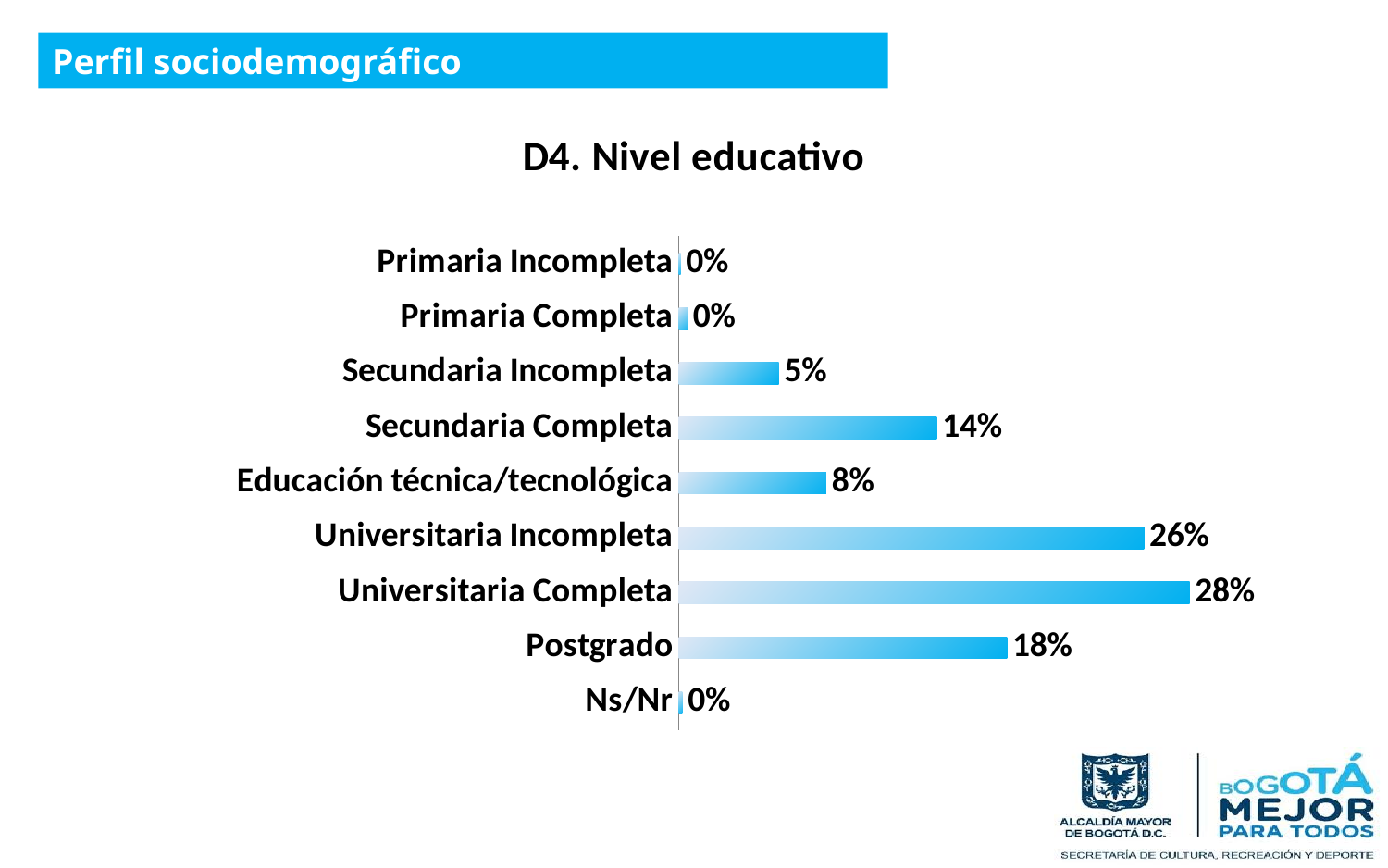
Which category has the highest value? Universitaria Completa Which is larger, Postgrado or Universitaria Incompleta? Universitaria Incompleta What kind of chart is shown on the slide? Bar chart Which is larger, Secundaria Completa or Educación técnica/tecnológica? Secundaria Completa What is the title of the chart? D4. Nivel educativo What is the value for Secundaria Completa? 14% What is the value for Universitaria Completa? 28% What is the difference between Postgrado and Secundaria Incompleta? 13% What is the difference between Universitaria Completa and Universitaria Incompleta? 2% What is the value for Postgrado? 18% What is the value for Educación técnica/tecnológica? 8% How many categories are shown in the chart? 9